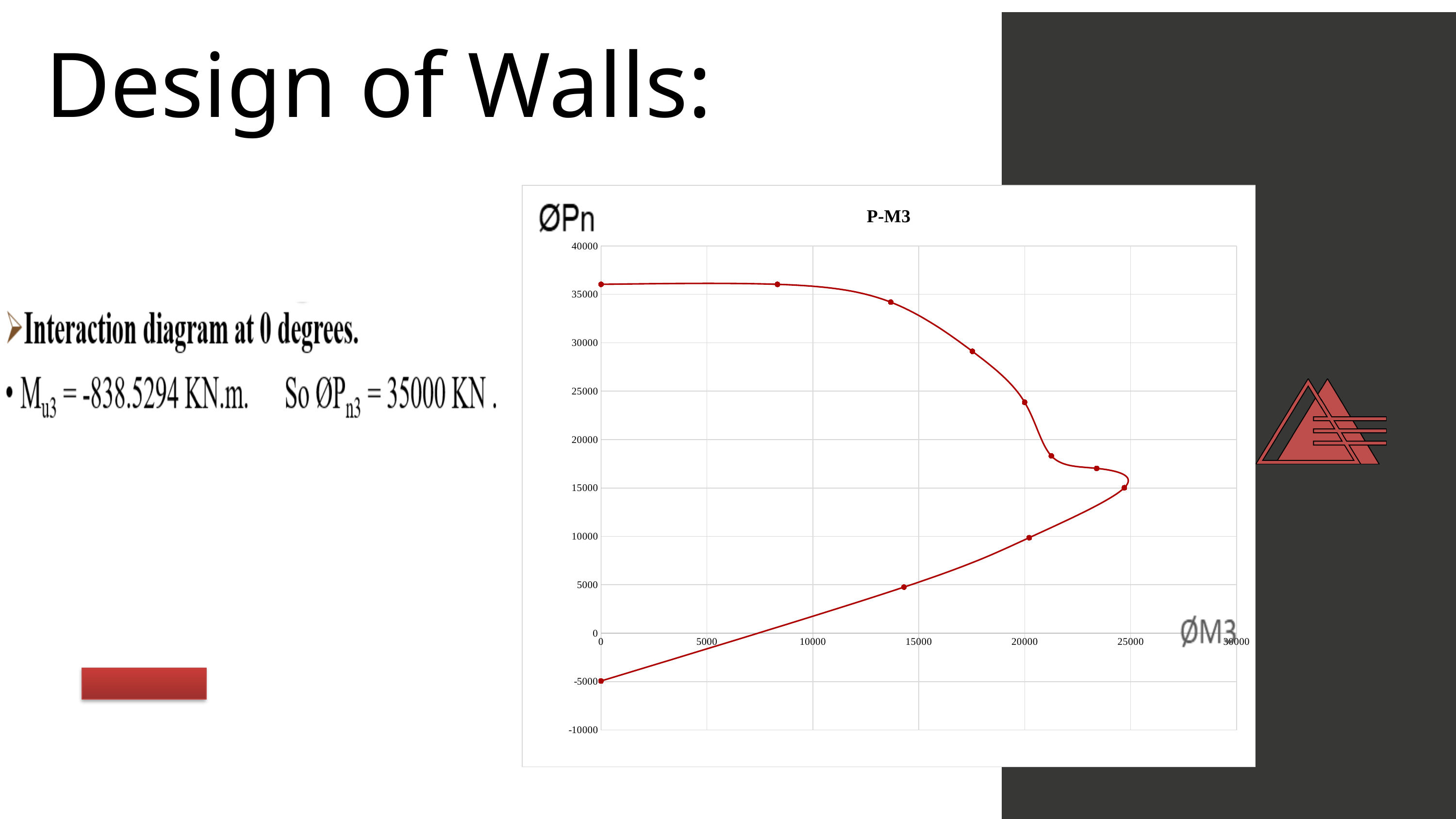
What label is shown on the vertical axis of the P-M3 chart? ØPn What is the highest value shown on the vertical axis of the P-M3 chart? 40000 How many data points are marked on the P-M3 curve? 11 What kind of chart is the P-M3 chart? line chart Is the ØM3 value of the rightmost point on the P-M3 curve greater or less than 20000? greater What is the highest value shown on the horizontal axis of the P-M3 chart? 30000 What is the lowest value shown on the vertical axis of the P-M3 chart? -10000 Is the ØPn value of the highest point on the P-M3 curve greater or less than 35000? greater How many series are plotted on the P-M3 chart? 1 What is the title of the chart on the slide? P-M3 Is the ØPn value of the lowest point on the P-M3 curve greater or less than 0? less